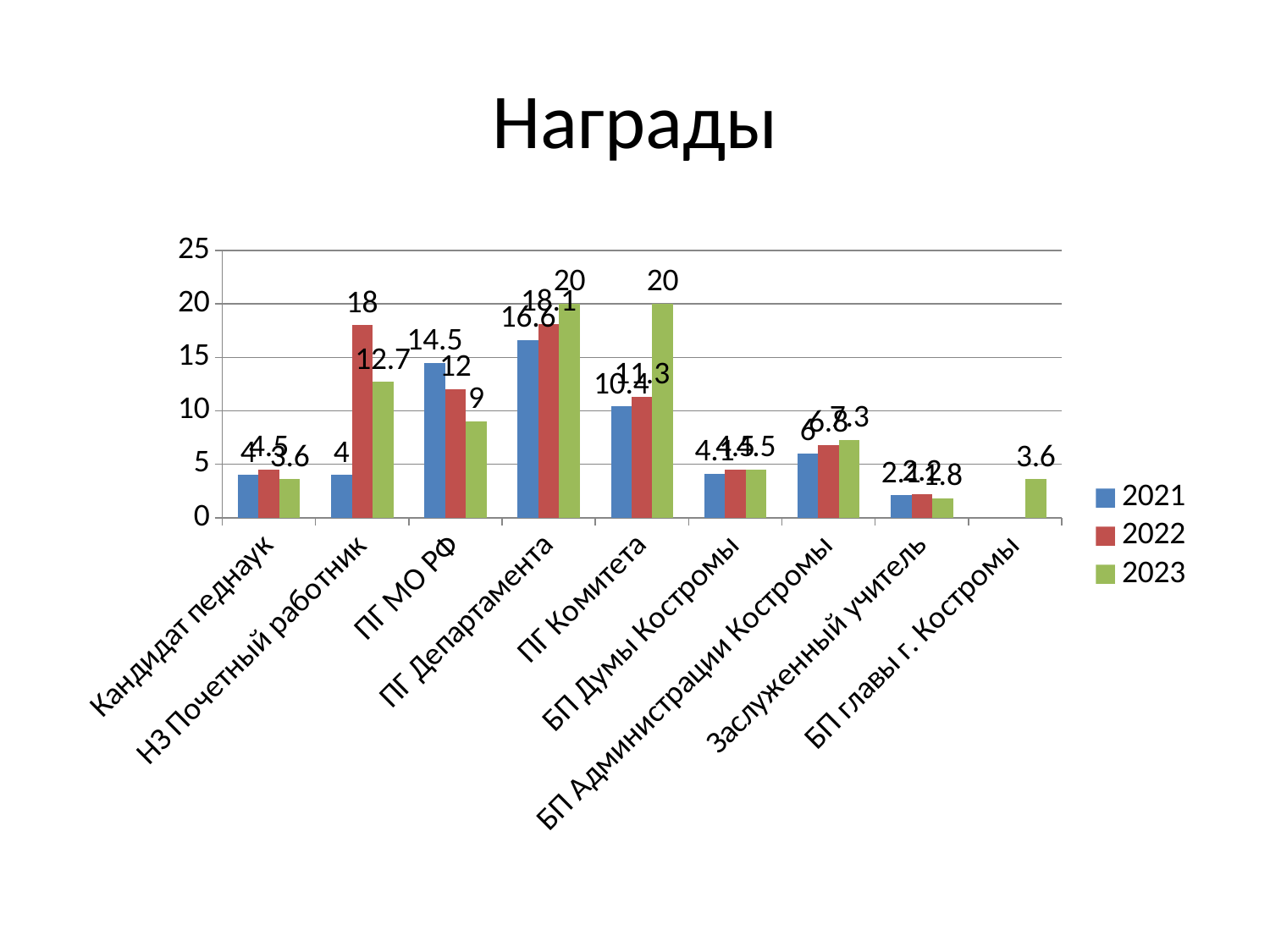
What is the 2023 value for ПГ Департамента? 20 What is the title of the chart? Награды Do the values for ПГ МО РФ rise or fall from 2021 to 2023? fall What is the 2023 value for БП главы г. Костромы? 3.6 How many categories are shown on the x axis? 9 What is the 2022 value for НЗ Почетный работник? 18 Which category has the highest 2021 value? ПГ Департамента What is the difference between the 2021 and 2023 values for ПГ МО РФ? 5.5 What kind of chart is shown on the slide? bar chart For ПГ Комитета, which year has the larger value, 2021 or 2023? 2023 What is the 2021 value for ПГ МО РФ? 14.5 How many series does the legend list? 3